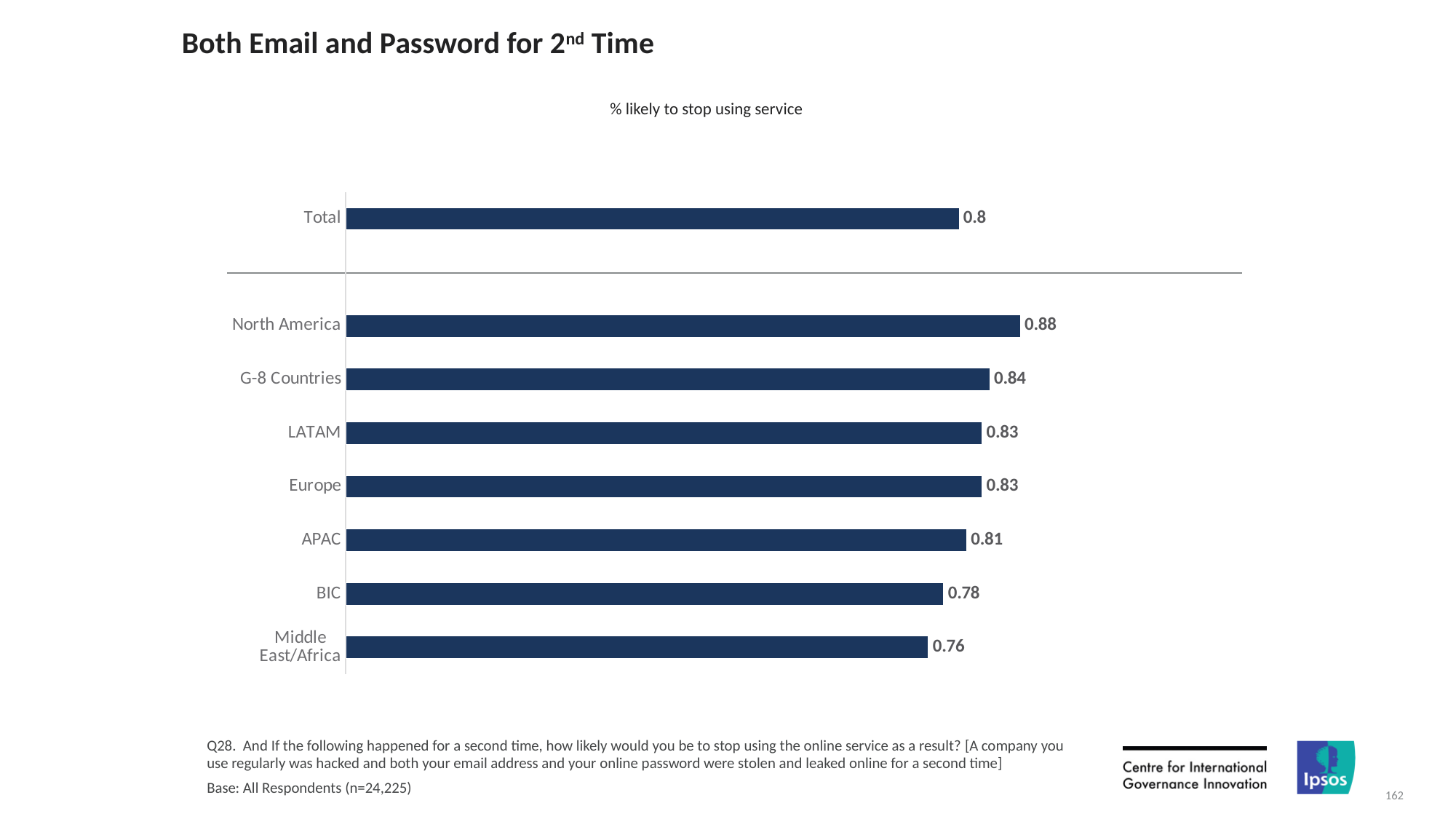
Which region has the highest value? North America What is the difference between the values for North America and Middle East/Africa? 0.12 Which region has the lowest value? Middle East/Africa What kind of chart is shown on the slide? Bar chart What is the value for the Total bar? 0.8 How many bars are shown in the chart, including Total? 8 Which is larger, the value for APAC or the value for BIC? APAC What is the difference between the values for G-8 Countries and APAC? 0.03 What is the value for BIC? 0.78 What is the value for North America? 0.88 What is the value for Middle East/Africa? 0.76 What is the subtitle shown above the chart? % likely to stop using service